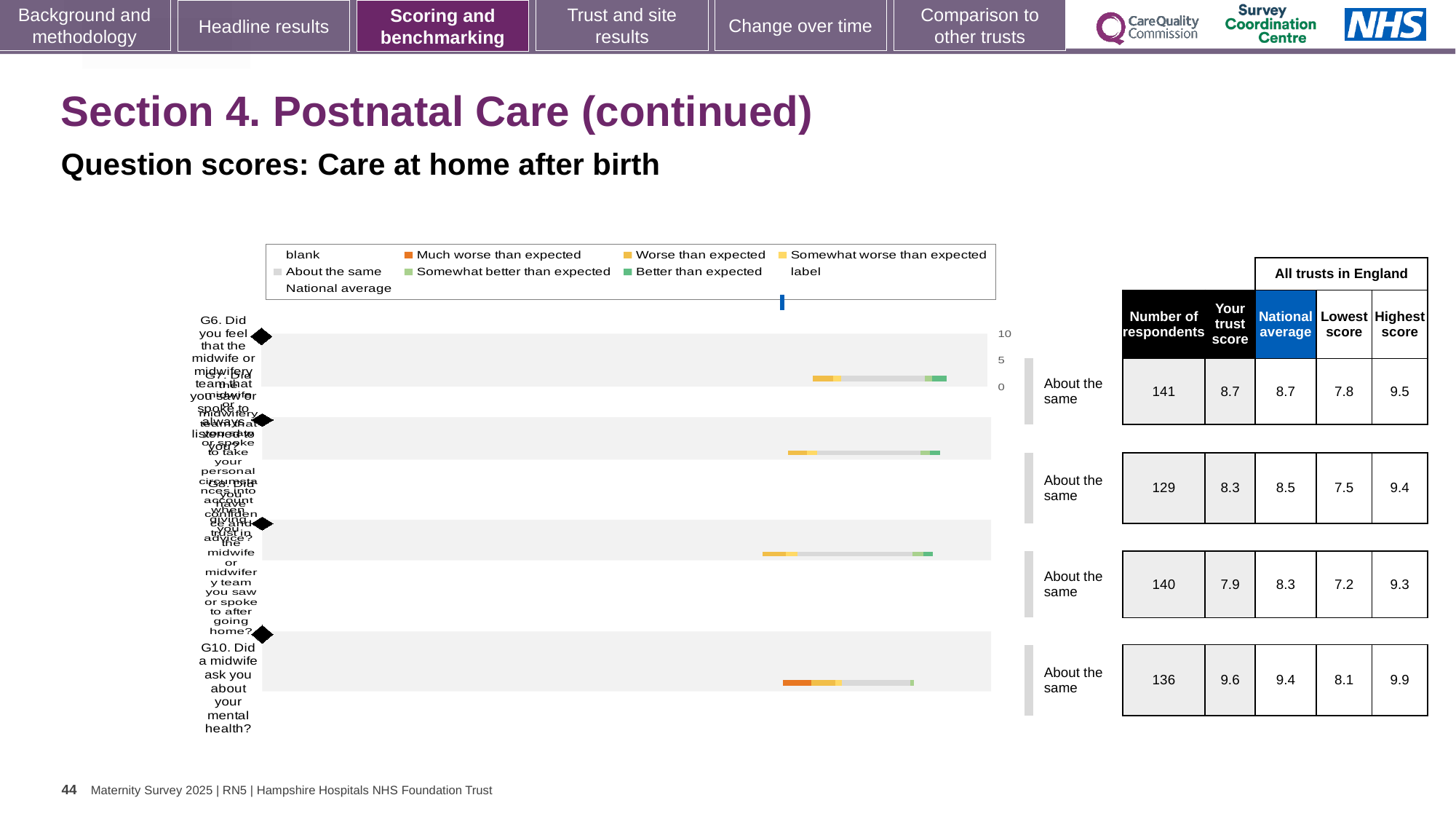
For G10, which is larger: the trust score or the national average? the trust score What kind of chart is used to show the question scores on this slide? bar chart What is the 'Your trust score' for G10 (Did a midwife ask you about your mental health?)? 9.6 Which question has the highest 'Your trust score' in the table? G10 How many questions (bars) are plotted in the chart? 4 How many respondents are listed for question G6? 141 What is the highest score among all trusts in England for G10? 9.9 What benchmark category is shown for every question on this slide? About the same How many entries does the chart legend list? 9 What is the difference between the highest score and the lowest score for G6? 1.7 What is the lowest 'Your trust score' value shown in the table? 7.9 By how much does the trust score for G10 exceed the national average for G10? 0.2